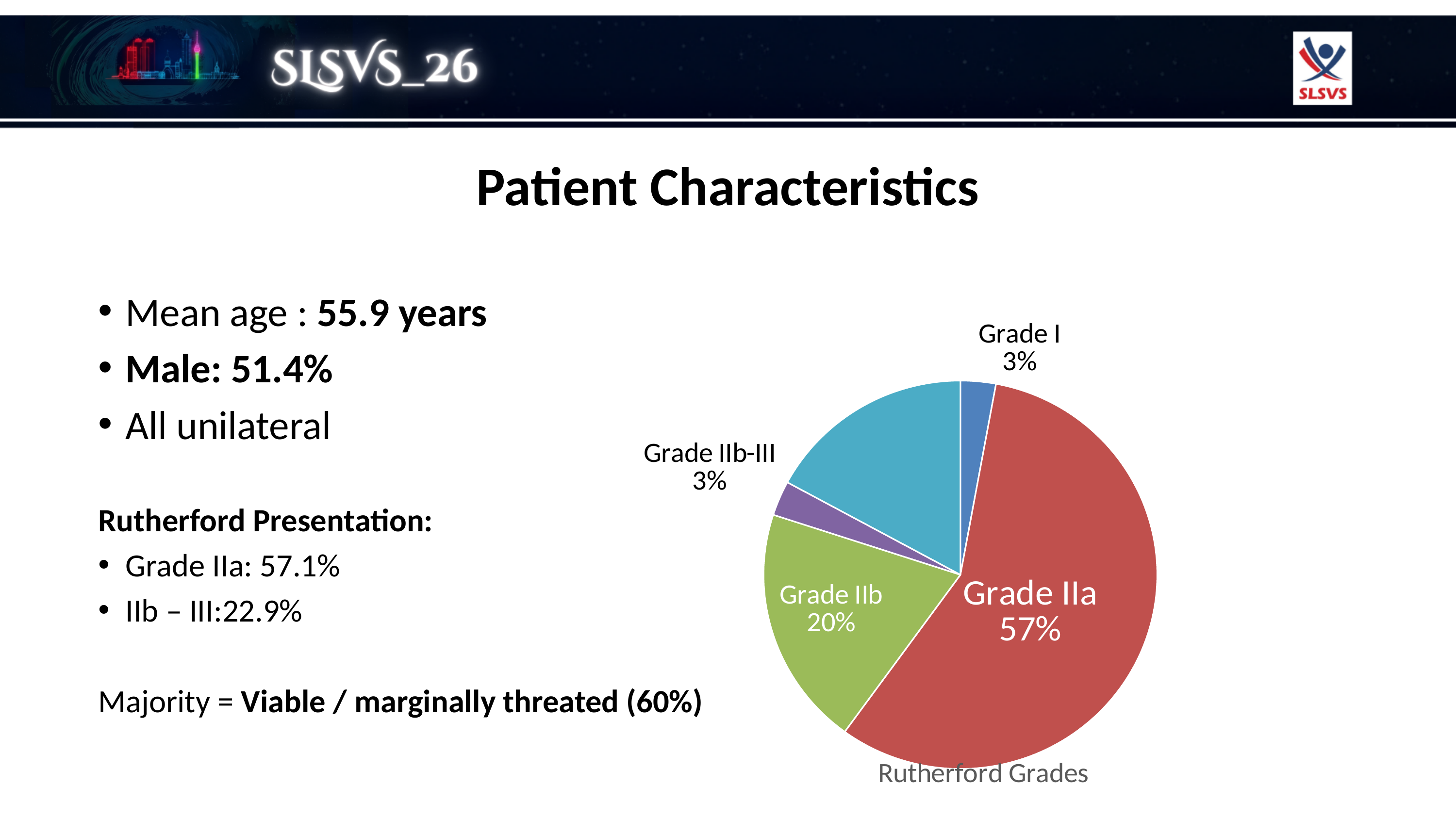
What type of chart is used to show the Rutherford Grades? Pie chart Which slice is larger in the pie chart, Grade IIa or Grade IIb? Grade IIa What percentage is shown for Grade I in the pie chart? 3% By how many percentage points does the Grade IIa share exceed the Grade IIb share in the pie chart? 37 percentage points What colour is the Grade IIa slice in the pie chart? Red What share of the pie does Grade IIa represent in the Rutherford Grades chart? 57% What percentage is shown for Grade IIb in the pie chart? 20% Which grade has the largest slice in the Rutherford Grades pie chart? Grade IIa How many slices does the Rutherford Grades pie chart contain? 5 What is the title shown beneath the pie chart? Rutherford Grades What percentage is shown for Grade IIb-III in the pie chart? 3%